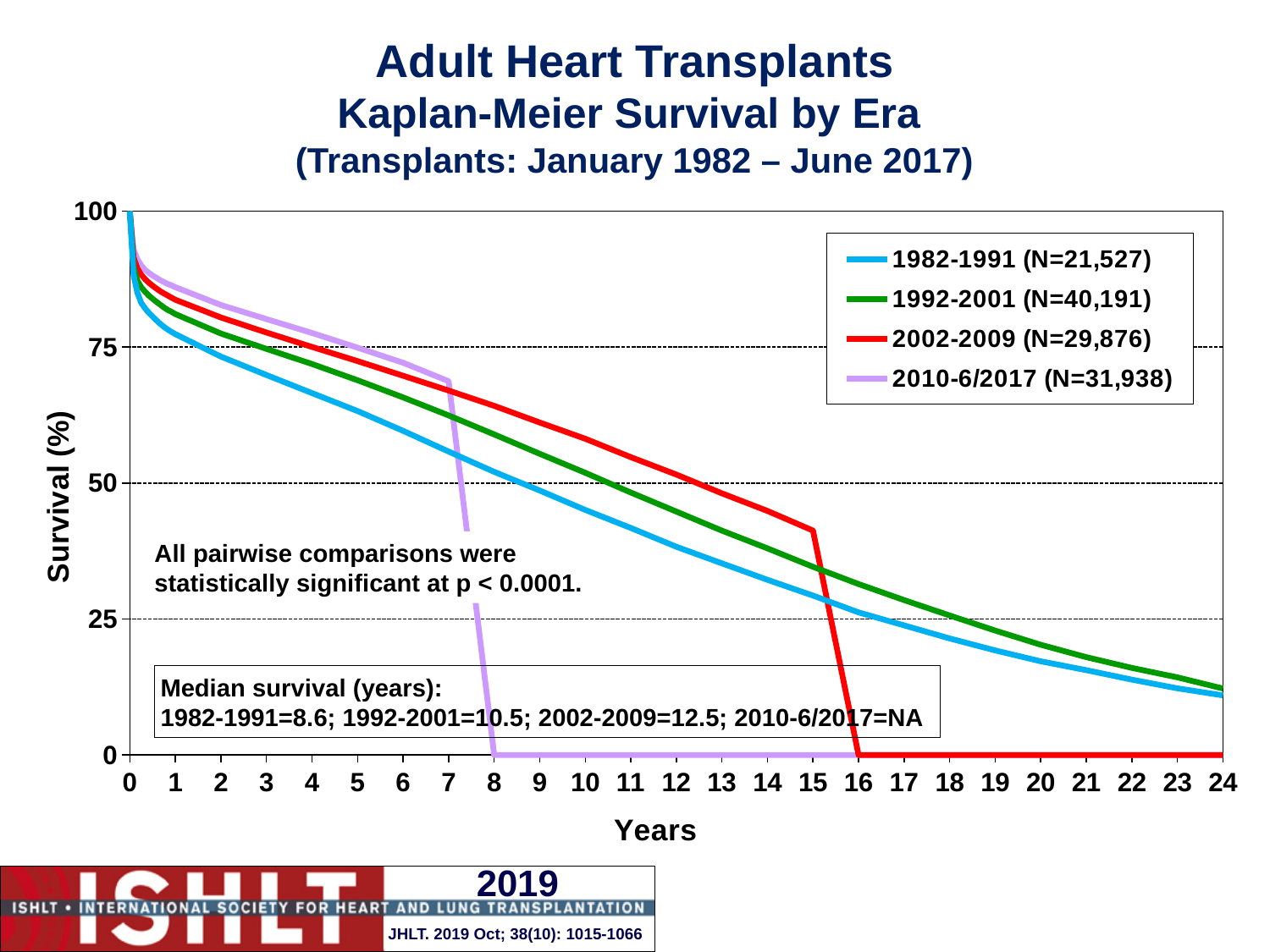
How many series (eras) does the legend list? 4 What is the difference in median survival (years) between the 2002-2009 era and the 1982-1991 era? 3.9 What is the median survival in years for the 2002-2009 era? 12.5 Is the survival value for the 2010-6/2017 era at 3 years greater or less than 75? greater At 10 years, which era has higher survival, 1992-2001 or 1982-1991? 1992-2001 What kind of chart is shown on the slide? Line chart Is the survival value for the 1982-1991 era at 5 years greater or less than 50? greater Which era has the largest N in the legend? 1992-2001 (N=40,191) Do the survival curves rise or fall as years increase? Fall Is the survival value for the 2002-2009 era at 15 years greater or less than 25? greater What is the N for the 1982-1991 era shown in the legend? 21,527 What colour is the line for the 2002-2009 era? Red